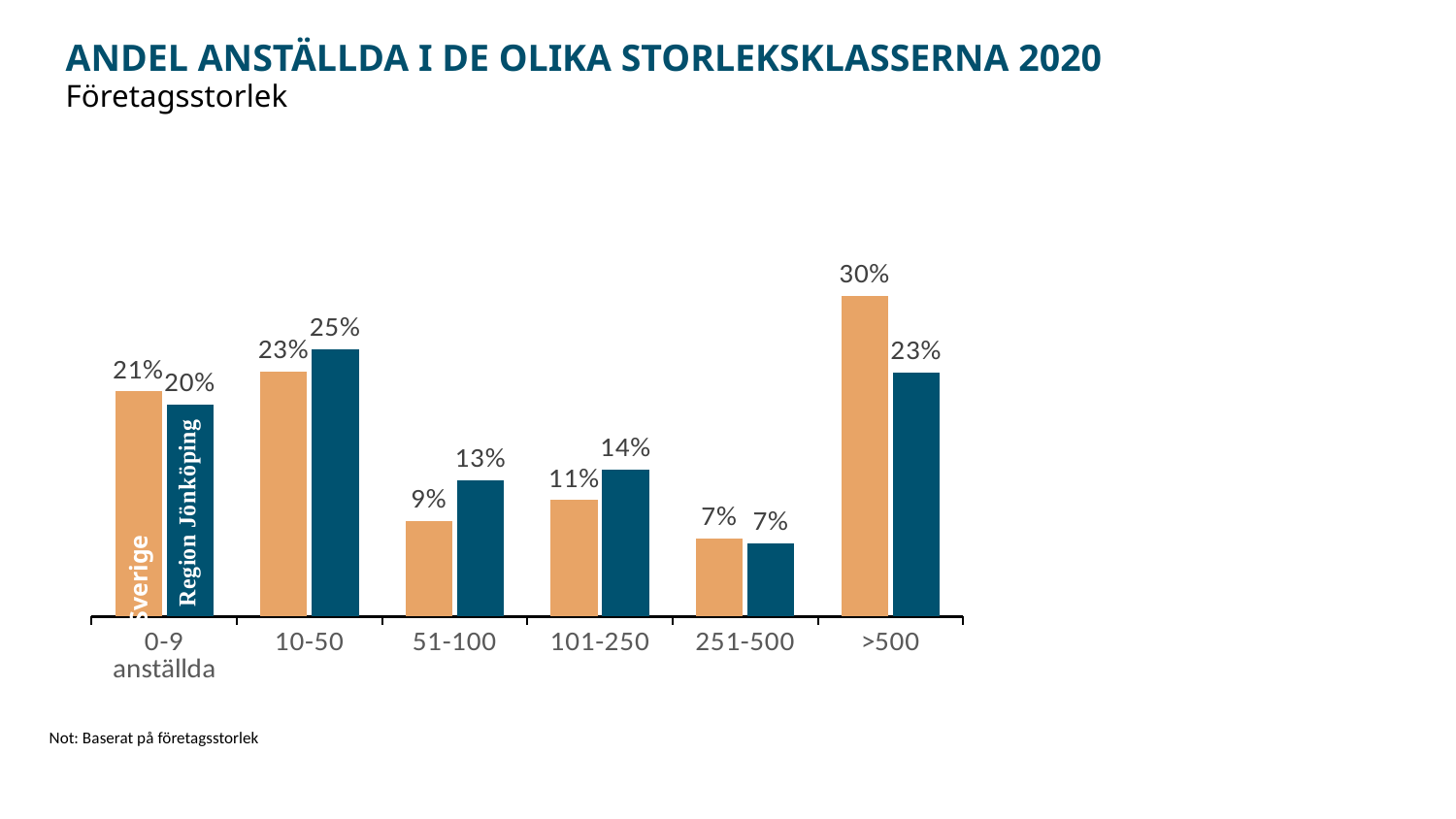
Which is larger in the 51-100 category, Sverige or Region Jönköping? Region Jönköping How many categories are shown on the x axis? 6 How many series does the chart show? 2 Which category has the lowest value for Region Jönköping? 251-500 What is the difference between Sverige and Region Jönköping in the >500 category? 7% What kind of chart is shown on the slide? Bar chart What is the value for Sverige in the 0-9 anställda category? 21% What is the title of the chart? ANDEL ANSTÄLLDA I DE OLIKA STORLEKSKLASSERNA 2020 What is the value for Sverige in the >500 category? 30% What is the value for Region Jönköping in the 101-250 category? 14% Which category has the highest value for Sverige? >500 What is the value for Region Jönköping in the 10-50 category? 25%